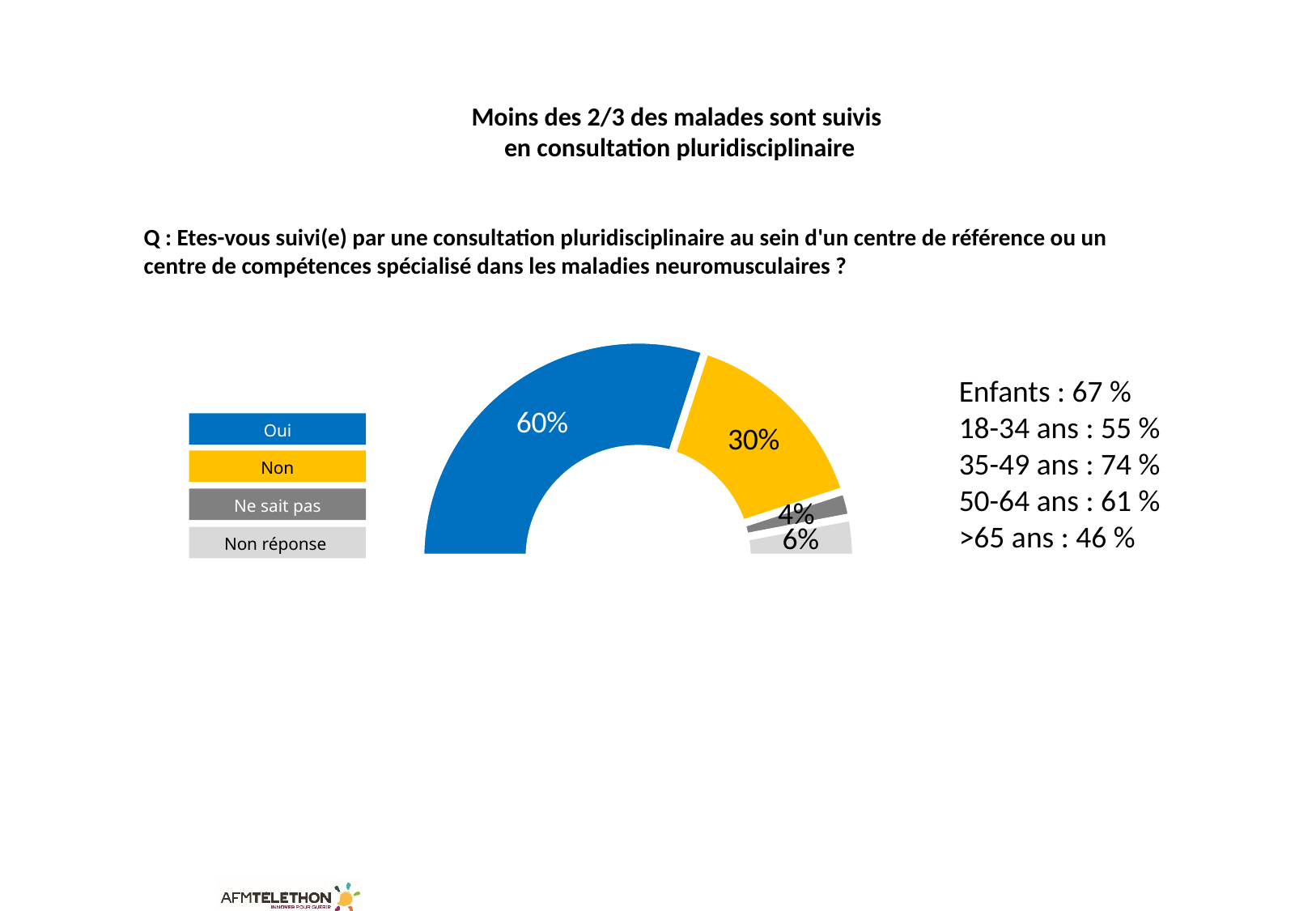
What percentage of respondents answered "Non"? 30% Which category has the smallest share in the chart? Ne sait pas What is the difference in percentage points between "Oui" and "Non"? 30 What colour represents the "Non" category in the chart? Yellow What kind of chart is shown on the slide? Doughnut (half-pie) chart What is the combined share of "Ne sait pas" and "Non réponse"? 10% How many categories are shown in the chart? 4 What percentage is shown for "Non réponse"? 6% What percentage is shown for "Ne sait pas"? 4% What percentage of respondents answered "Oui"? 60% Which is larger, the share for "Non réponse" or the share for "Ne sait pas"? Non réponse Which category has the largest share in the chart? Oui